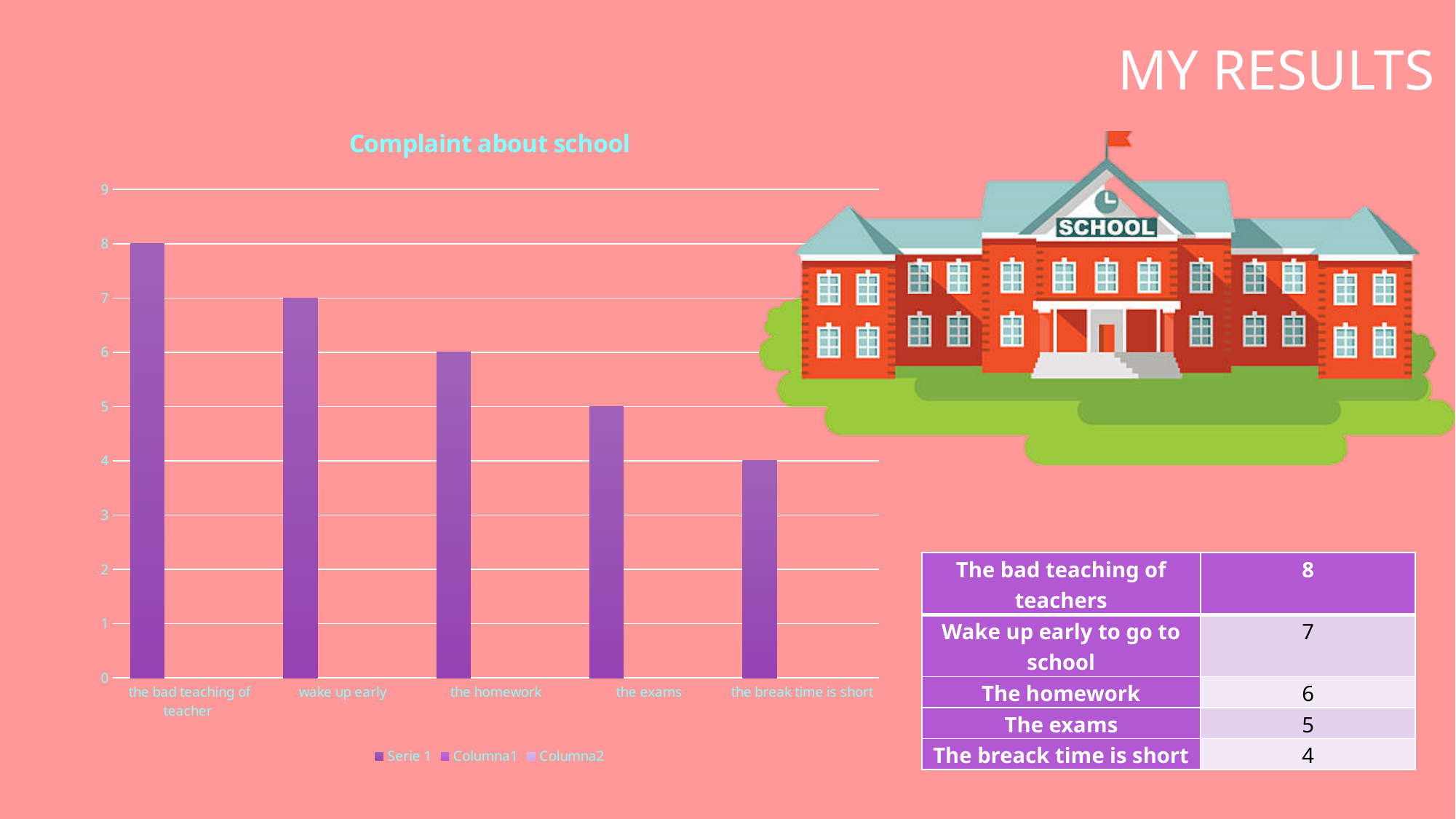
How many series does the chart legend list? 3 What is the difference between the values for 'wake up early' and 'the exams'? 2 What is the value for 'the bad teaching of teacher'? 8 What is the value for 'the homework'? 6 What is the value for 'the break time is short'? 4 What type of chart is shown on the slide? bar chart Which is larger, the value for 'the homework' or the value for 'the exams'? the homework Which category has the highest value? the bad teaching of teacher Do the values rise or fall from left to right along the x axis? fall How many categories are shown on the x axis of the chart? 5 Which category has the lowest value? the break time is short What is the title of the chart? Complaint about school